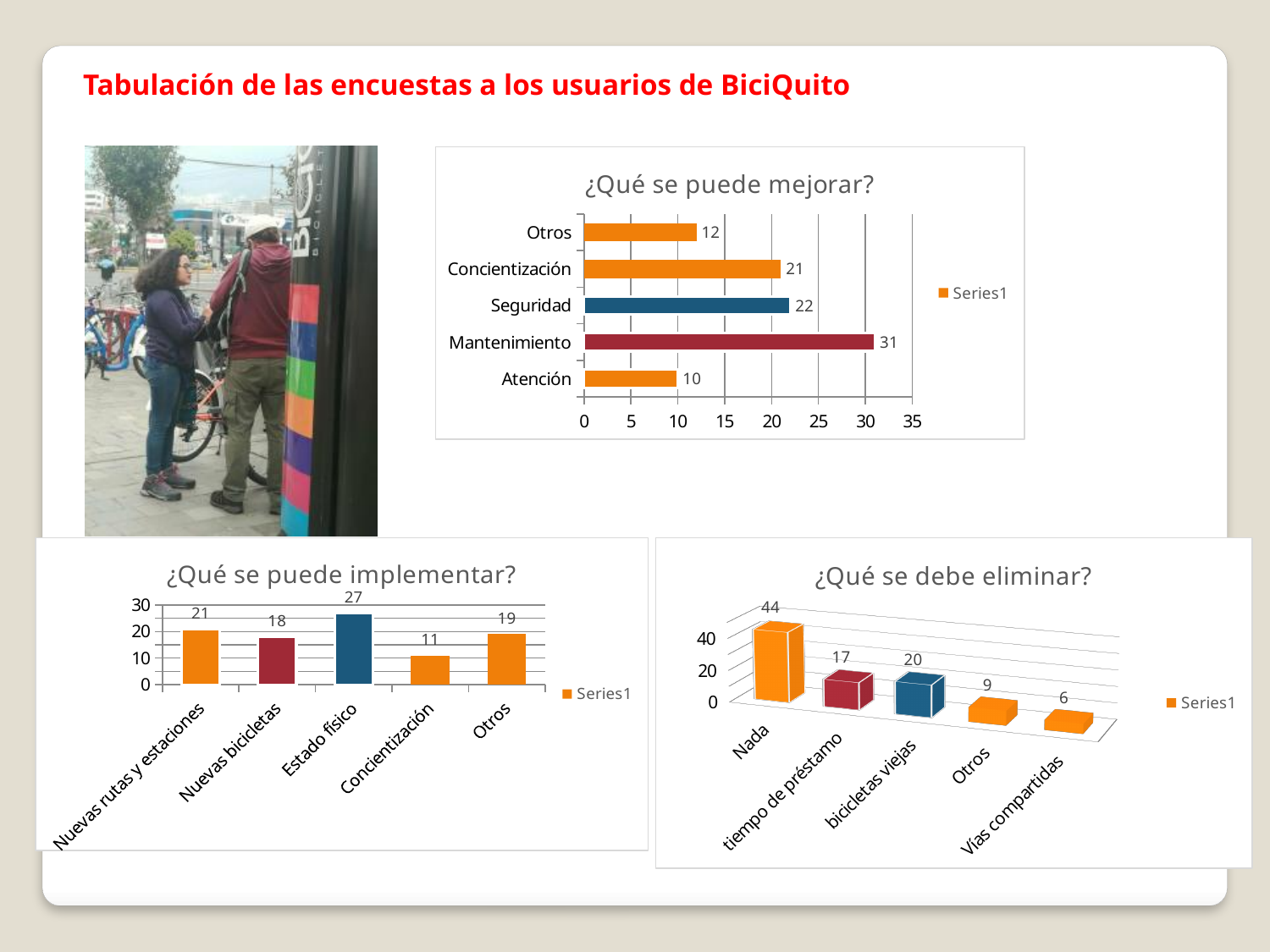
In the '¿Qué se puede implementar?' chart, which is larger: Nuevas rutas y estaciones or Nuevas bicicletas? Nuevas rutas y estaciones What kind of chart is '¿Qué se puede mejorar?'? Bar chart In the '¿Qué se debe eliminar?' chart, which category has the highest value? Nada In the '¿Qué se puede mejorar?' chart, which category has the lowest value? Atención In the '¿Qué se puede mejorar?' chart, how many categories are shown? 5 In the '¿Qué se puede mejorar?' chart, what is the value for Mantenimiento? 31 In the '¿Qué se puede implementar?' chart, what is the value for Estado físico? 27 How many series does the legend of the '¿Qué se debe eliminar?' chart list? 1 In the '¿Qué se debe eliminar?' chart, what is the value for Nada? 44 In the '¿Qué se puede implementar?' chart, which category has the lowest value? Concientización In the '¿Qué se puede mejorar?' chart, what is the difference between Seguridad and Otros? 10 In the '¿Qué se debe eliminar?' chart, what is the difference between bicicletas viejas and Vías compartidas? 14